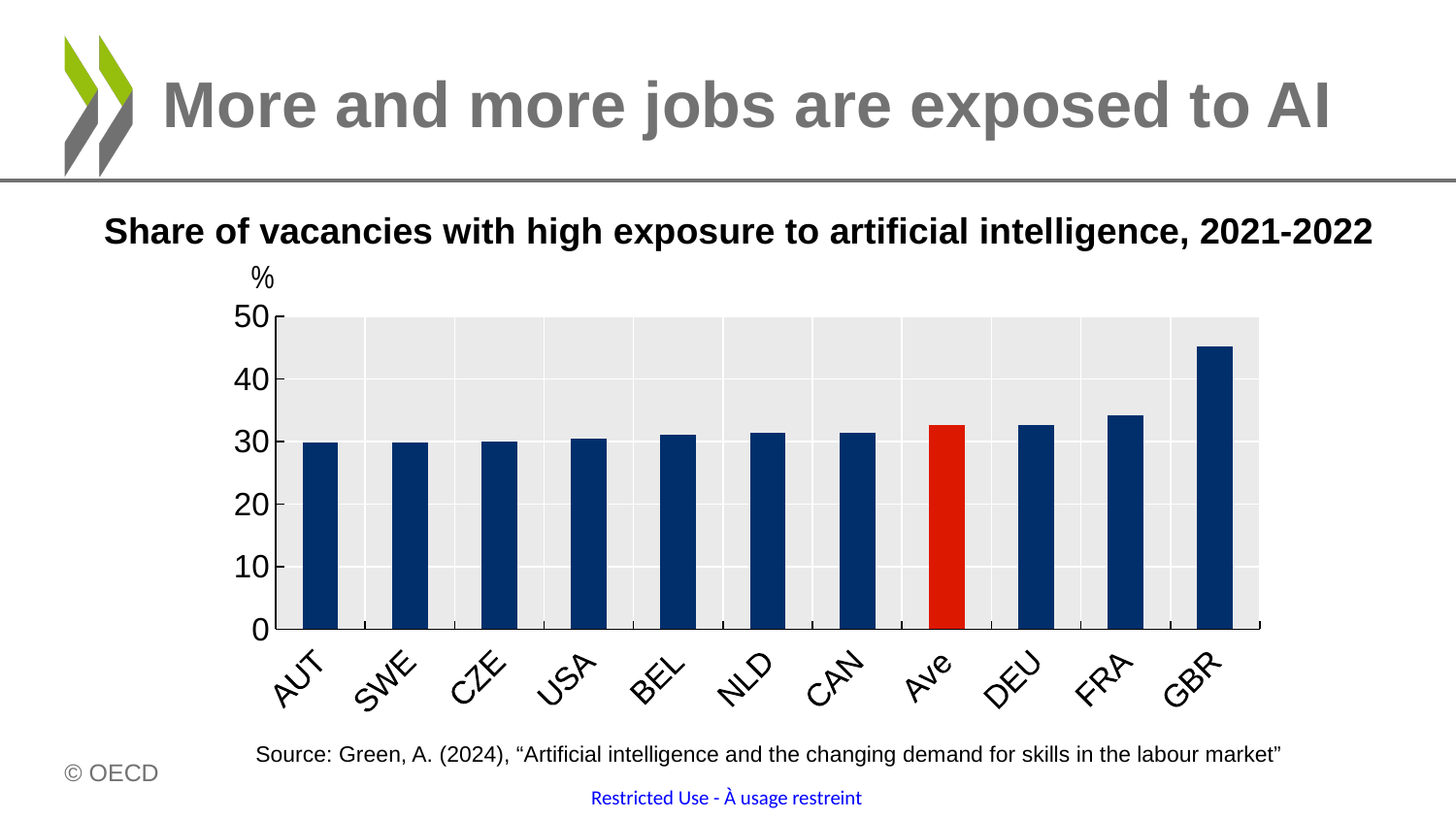
Do the bar values generally rise or fall from left to right along the x axis? rise How many countries or categories are shown on the x axis of the chart? 11 Which has a larger value, FRA or AUT? FRA Which category has the highest share of vacancies with high exposure to AI? GBR Is the value for AUT greater or less than 40? less What kind of chart is shown on the slide? bar chart Is the value for FRA greater or less than 40? less Which category is shown with a red bar instead of a blue one? Ave Is the value for GBR greater or less than 40? greater Which has a larger value, GBR or FRA? GBR What is the title of the chart? Share of vacancies with high exposure to artificial intelligence, 2021-2022